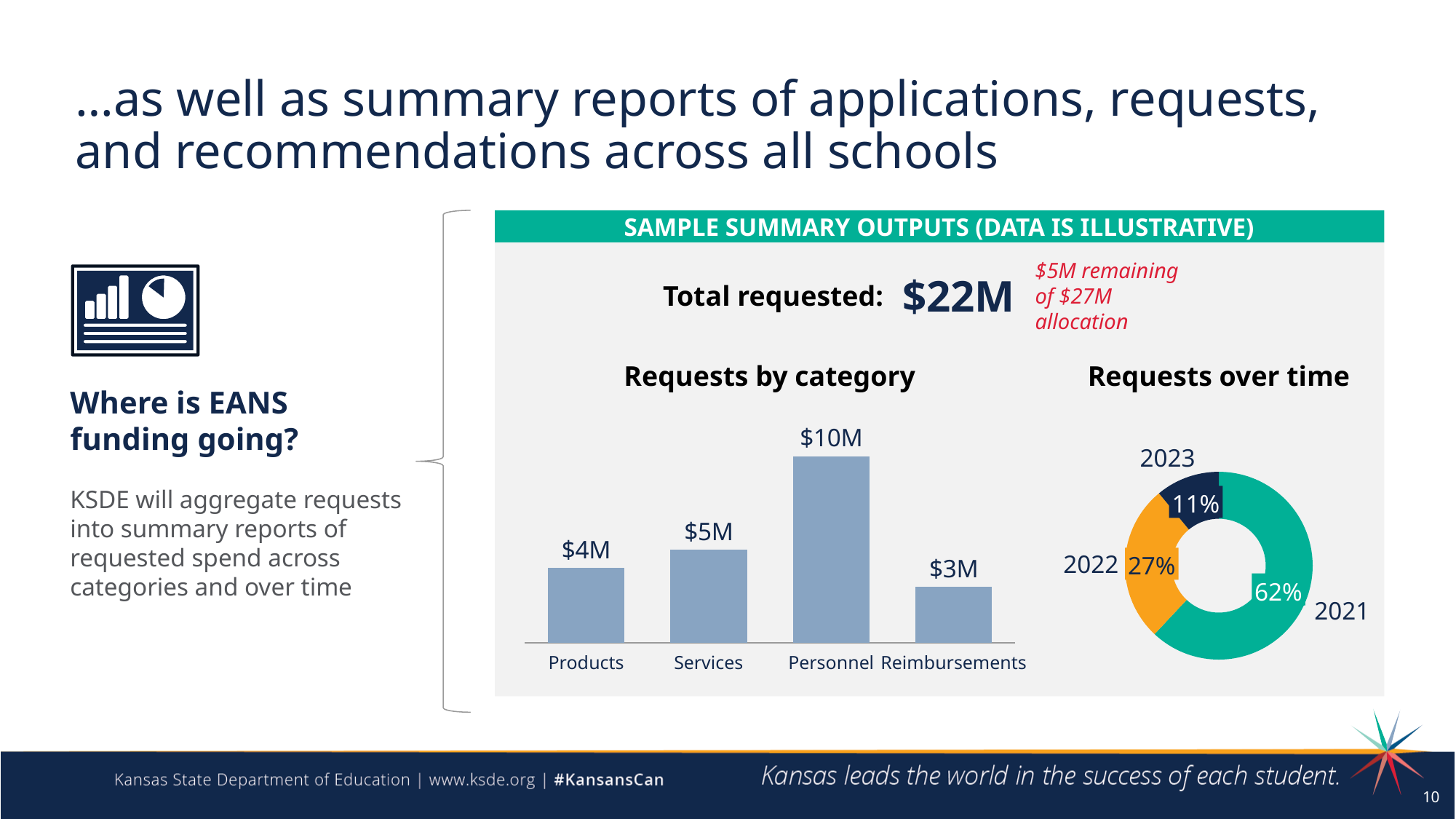
What kind of chart is 'Requests over time'? Doughnut chart In the 'Requests by category' chart, which category has the highest value? Personnel In the 'Requests by category' chart, what is the value for Personnel? $10M In the 'Requests by category' chart, which is larger, Products or Services? Services What kind of chart is 'Requests by category'? Bar chart In the 'Requests over time' chart, what share of requests is for 2023? 11% In the 'Requests by category' chart, what is the difference between Personnel and Services? $5M In the 'Requests over time' chart, what share of requests is for 2021? 62% In the 'Requests by category' chart, which category has the lowest value? Reimbursements How many categories are shown in the 'Requests by category' chart? 4 In the 'Requests over time' chart, which year has the smallest share? 2023 In the 'Requests by category' chart, what is the value for Reimbursements? $3M